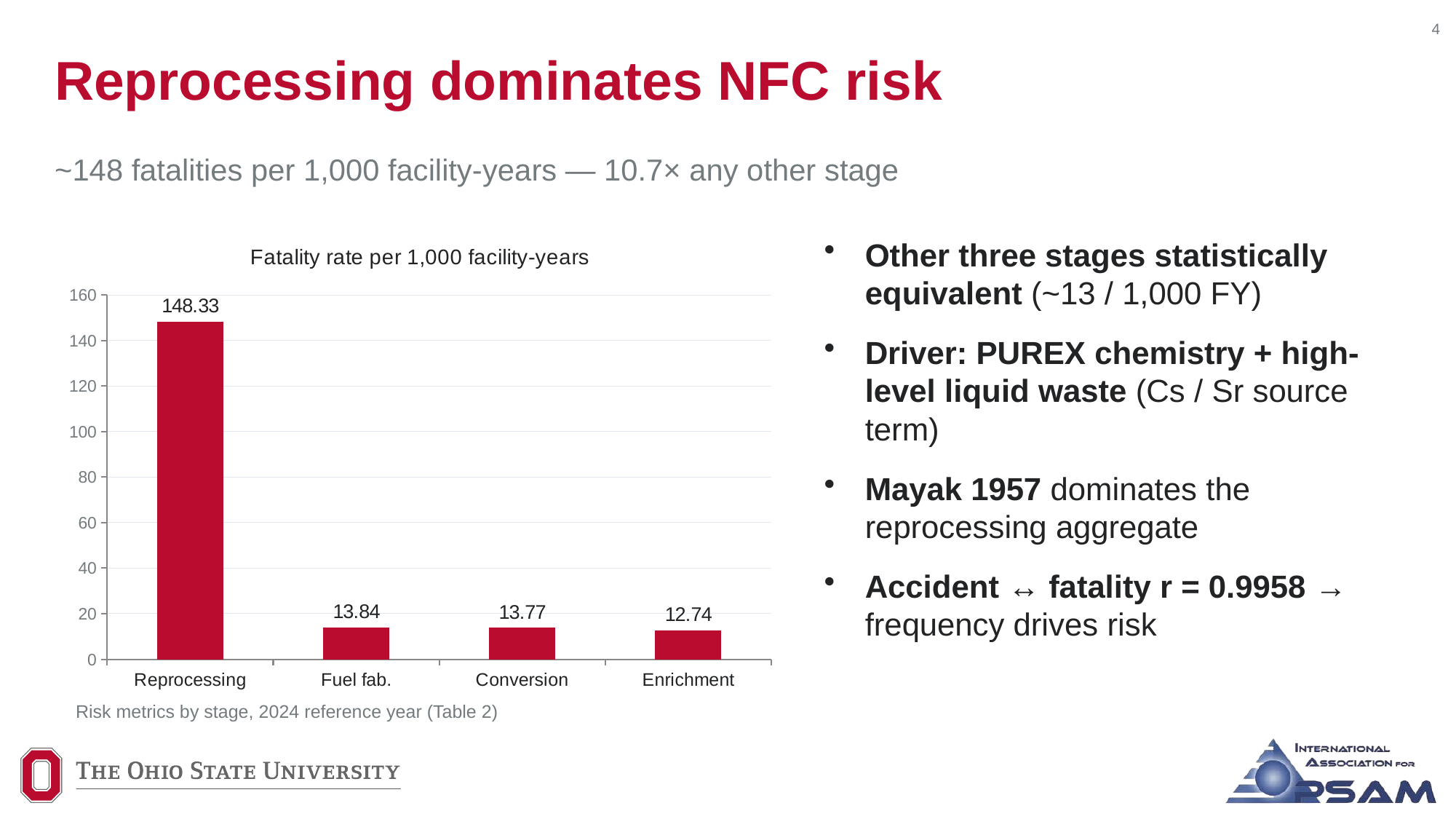
What is the difference between the fatality rates for Fuel fab. and Enrichment? 1.10 What is the fatality rate per 1,000 facility-years for Reprocessing? 148.33 Which stage has the highest fatality rate per 1,000 facility-years? Reprocessing What is the difference between the fatality rates for Reprocessing and Conversion? 134.56 Which has a higher fatality rate, Reprocessing or Fuel fab.? Reprocessing What is the fatality rate per 1,000 facility-years for Enrichment? 12.74 What is the fatality rate per 1,000 facility-years for Fuel fab.? 13.84 Which stage has the lowest fatality rate per 1,000 facility-years? Enrichment Is the value for Reprocessing greater or less than 140? greater What kind of chart is shown on the slide? bar chart What is the title of the chart? Fatality rate per 1,000 facility-years How many stages are shown on the x axis of the chart? 4